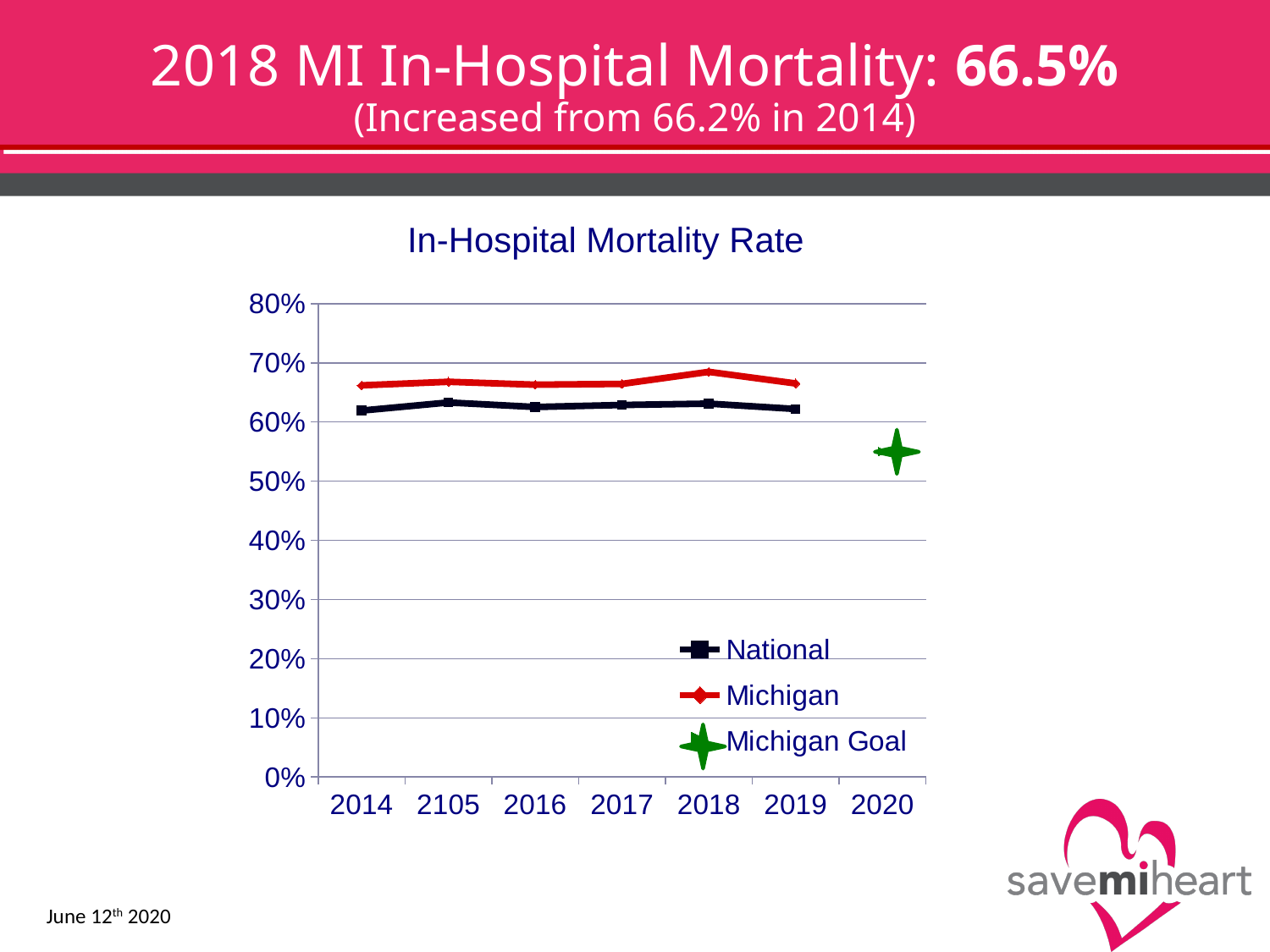
In which year does the Michigan line reach its highest value? 2018 How many series does the chart legend list? 3 What type of chart is shown on the slide? Line chart According to the slide, what was the Michigan in-hospital mortality rate in 2018? 66.5% Is the National value for 2017 greater or less than 50%? greater What is the title of the chart? In-Hospital Mortality Rate According to the slide, what was the Michigan in-hospital mortality rate in 2014? 66.2% By how many percentage points did the Michigan in-hospital mortality rate increase from 2014 to 2018, according to the slide? 0.3 Does the Michigan line rise or fall from 2018 to 2019? Fall In 2018, which series has the higher value, Michigan or National? Michigan Is the Michigan Goal value for 2020 greater or less than 60%? less How many year labels are shown on the x axis of the chart? 7